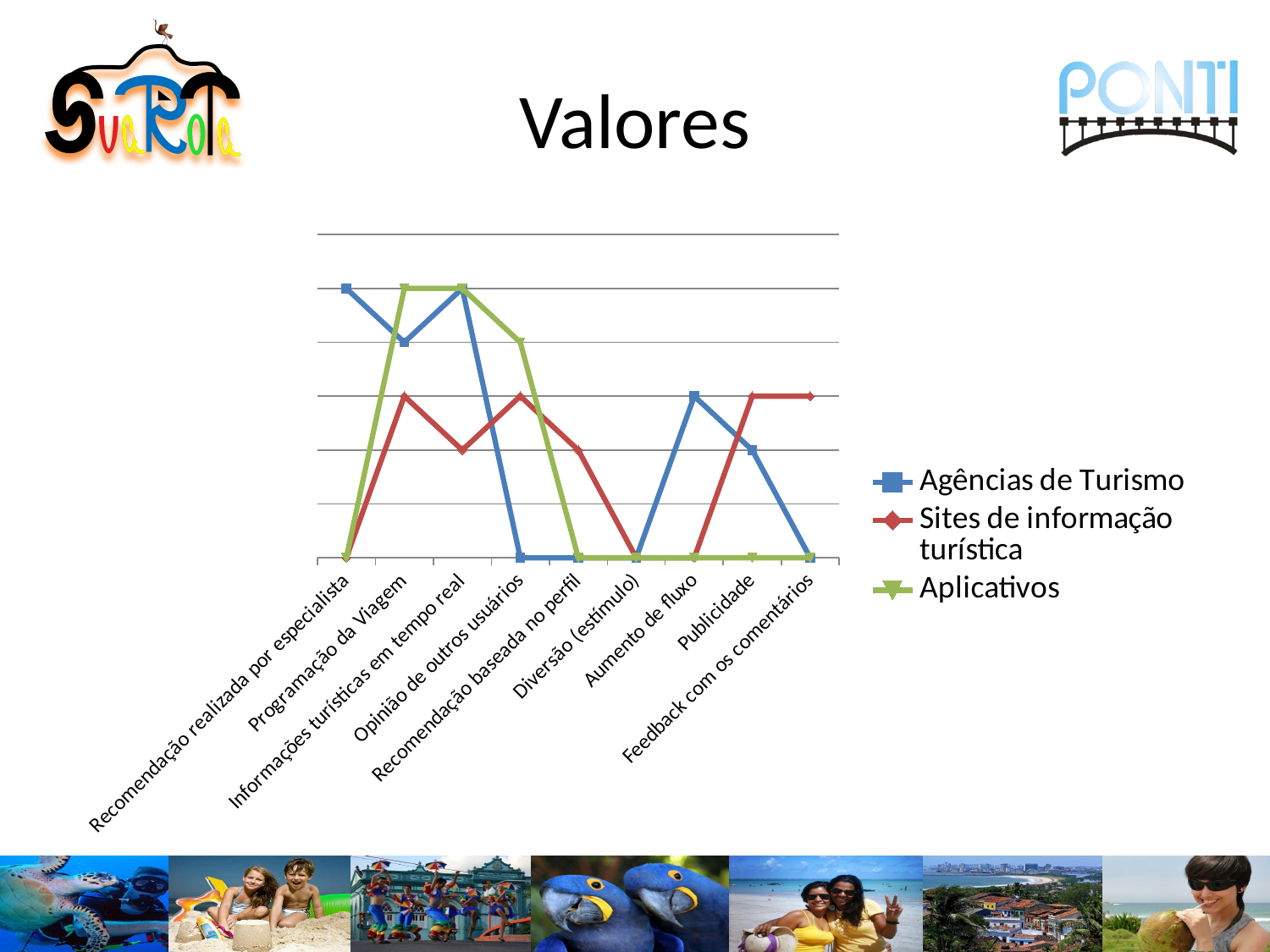
Does the Agências de Turismo line rise or fall from 'Informações turísticas em tempo real' to 'Opinião de outros usuários'? Fall How many categories are shown along the x axis? 9 How many series does the legend list? 3 Which series has the highest value for 'Aumento de fluxo'? Agências de Turismo What kind of chart is shown on the slide? Line chart Which series has the lowest value for 'Programação da Viagem'? Sites de informação turística For 'Opinião de outros usuários', which is larger: Aplicativos or Agências de Turismo? Aplicativos Does the Aplicativos line rise or fall from 'Recomendação realizada por especialista' to 'Programação da Viagem'? Rise Which series is represented by the green line with triangle markers? Aplicativos For 'Publicidade', which is larger: Agências de Turismo or Sites de informação turística? Sites de informação turística Which series has the highest value for 'Recomendação realizada por especialista'? Agências de Turismo What is the title of the chart slide? Valores